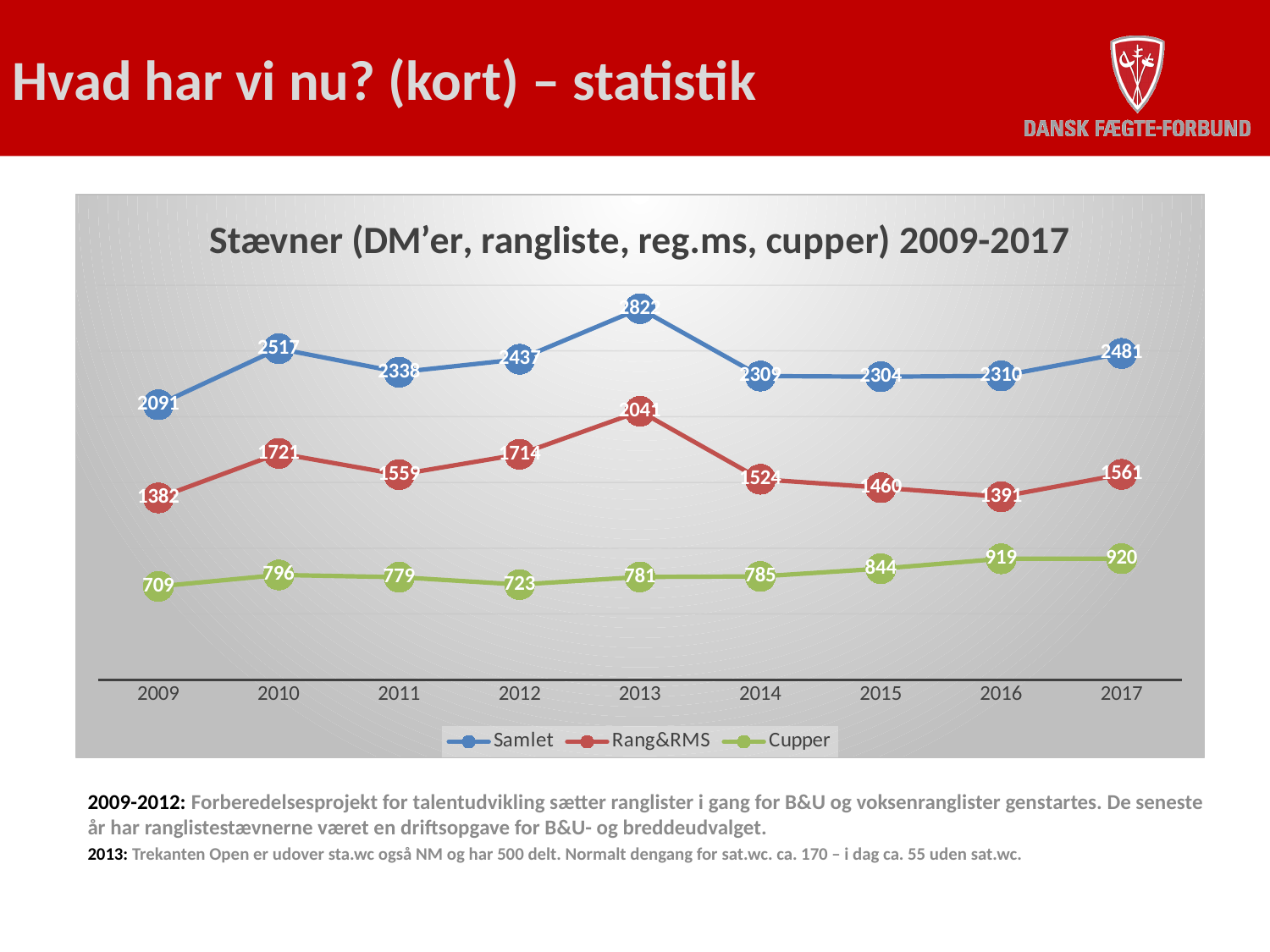
How many series does the legend list? 3 What is the value for Cupper in 2017? 920 What is the value for Samlet in 2010? 2517 What is the value for Rang&RMS in 2015? 1460 What type of chart is shown on the slide? line chart What is the difference between the Samlet value in 2017 and the Samlet value in 2009? 390 What is the title of the chart? Stævner (DM’er, rangliste, reg.ms, cupper) 2009-2017 Does the Cupper series rise or fall from 2014 to 2017? rise Which is larger, the Rang&RMS value in 2010 or the Rang&RMS value in 2012? 2010 How many years are shown on the x axis? 9 In which year is the Samlet series at its highest? 2013 In which year is the Cupper series at its lowest? 2009